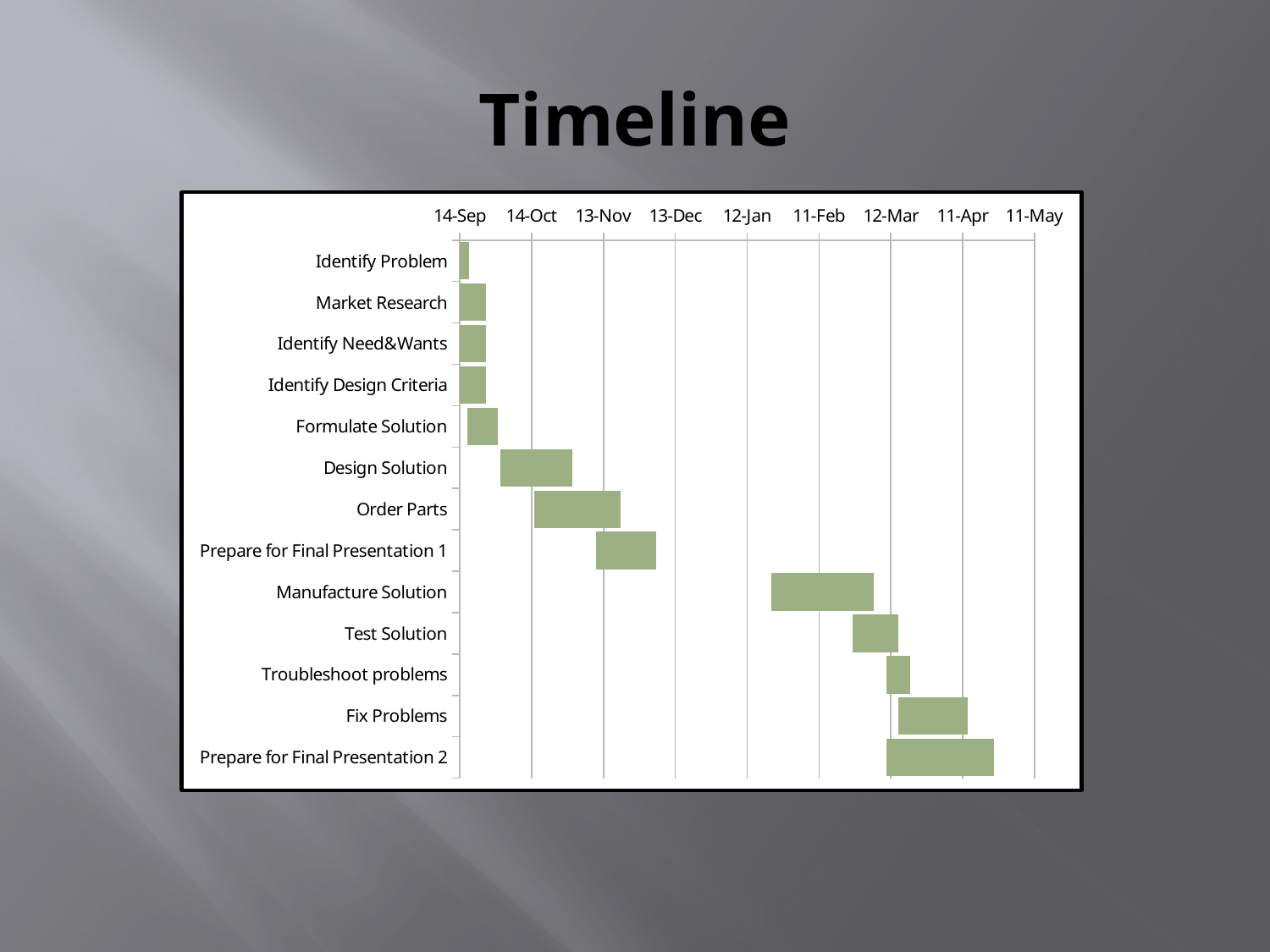
Which task starts later: Test Solution or Fix Problems? Fix Problems Does the bar for Order Parts end before or after the 13-Dec tick? before Which bar is longer: Design Solution or Formulate Solution? Design Solution Which task is listed first (at the top) of the chart? Identify Problem What kind of chart is shown on the Timeline slide? bar chart How many tasks are listed on the vertical axis of the chart? 13 Which task has the shortest bar in the chart? Identify Problem Does the bar for Design Solution start before or after the 14-Oct tick? before What is the title of the slide containing the chart? Timeline What is the first date label shown on the horizontal axis? 14-Sep Which task is listed last (at the bottom) of the chart? Prepare for Final Presentation 2 Does the bar for Manufacture Solution start before or after the 12-Jan tick? after